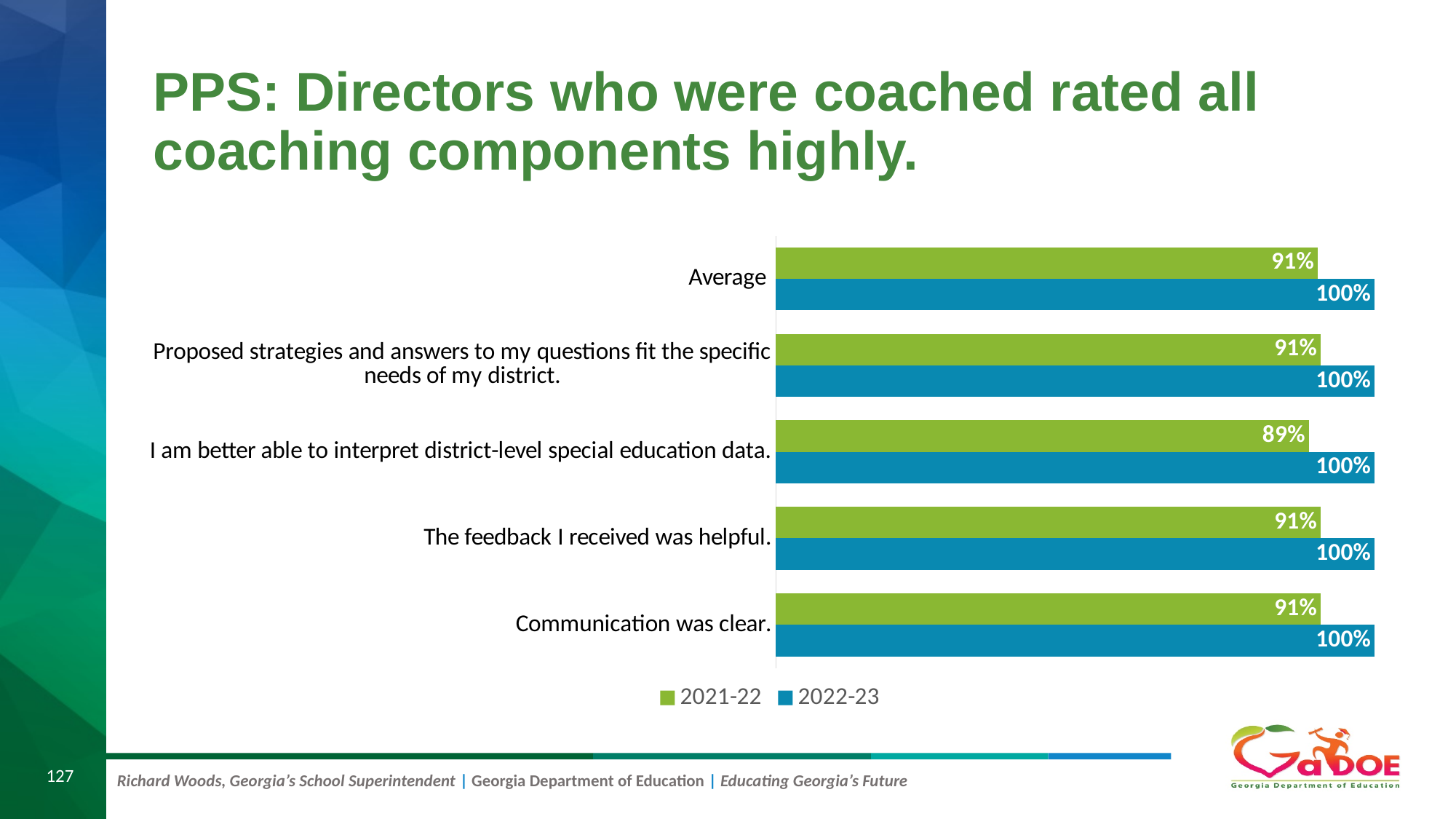
For "Proposed strategies and answers to my questions fit the specific needs of my district.", which series has the larger value, 2021-22 or 2022-23? 2022-23 How many categories are shown on the chart? 5 What is the difference between the 2022-23 and 2021-22 values for "Average"? 9% Which colour represents the 2022-23 series in the chart? Blue What is the 2021-22 value for "I am better able to interpret district-level special education data."? 89% What is the 2022-23 value for "Communication was clear."? 100% What kind of chart is shown on the slide? Bar chart What is the 2021-22 value for "The feedback I received was helpful."? 91% Which category has the lowest 2021-22 value? I am better able to interpret district-level special education data. What is the 2021-22 value for "Average"? 91% What is the difference between the 2022-23 and 2021-22 values for "I am better able to interpret district-level special education data."? 11% How many series does the legend list? 2